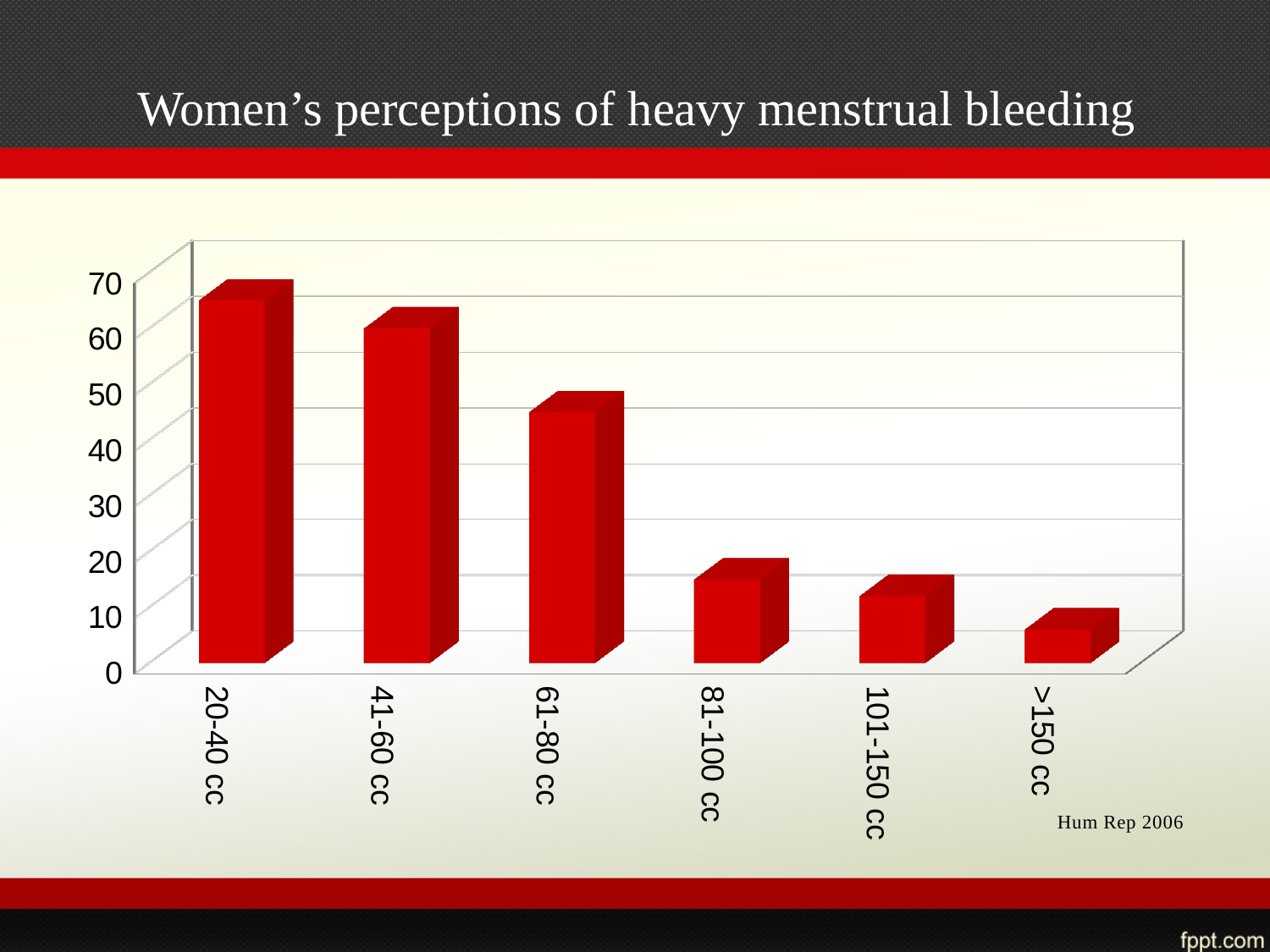
What kind of chart is shown on the slide? bar chart Is the value for 61-80 cc greater or less than 50? less Which is larger, the value for 61-80 cc or the value for 81-100 cc? 61-80 cc What source is cited below the chart? Hum Rep 2006 Is the value for 20-40 cc greater or less than 60? greater Is the value for 81-100 cc greater or less than 20? less How many categories are shown on the x axis of the chart? 6 What is the title of the slide containing the chart? Women's perceptions of heavy menstrual bleeding Which category has the lowest bar? >150 cc Which category has the highest bar? 20-40 cc Do the values rise or fall moving from left to right along the x axis? fall